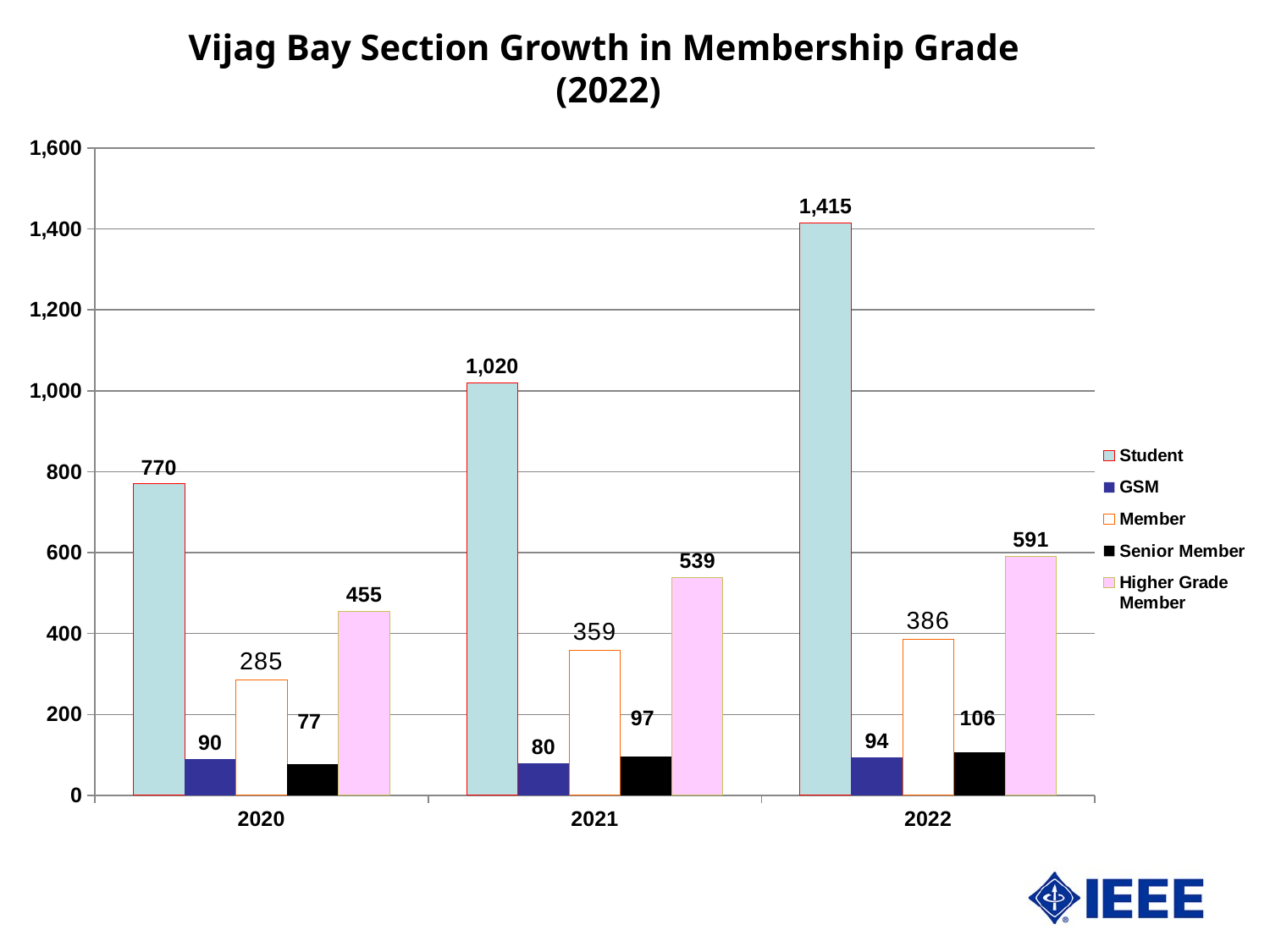
How many years are shown on the x axis? 3 What is the Member value for 2021? 359 What is the Student value for 2022? 1,415 How many series does the legend list? 5 What is the difference between the Student values for 2022 and 2021? 395 Which year has the lowest GSM value? 2021 What is the Higher Grade Member value for 2022? 591 Which is larger, the Higher Grade Member value for 2021 or the Member value for 2021? Higher Grade Member Do the Student values rise or fall from 2020 to 2022? Rise Which year has the highest Student value? 2022 What kind of chart is shown? Bar chart What is the Senior Member value for 2020? 77